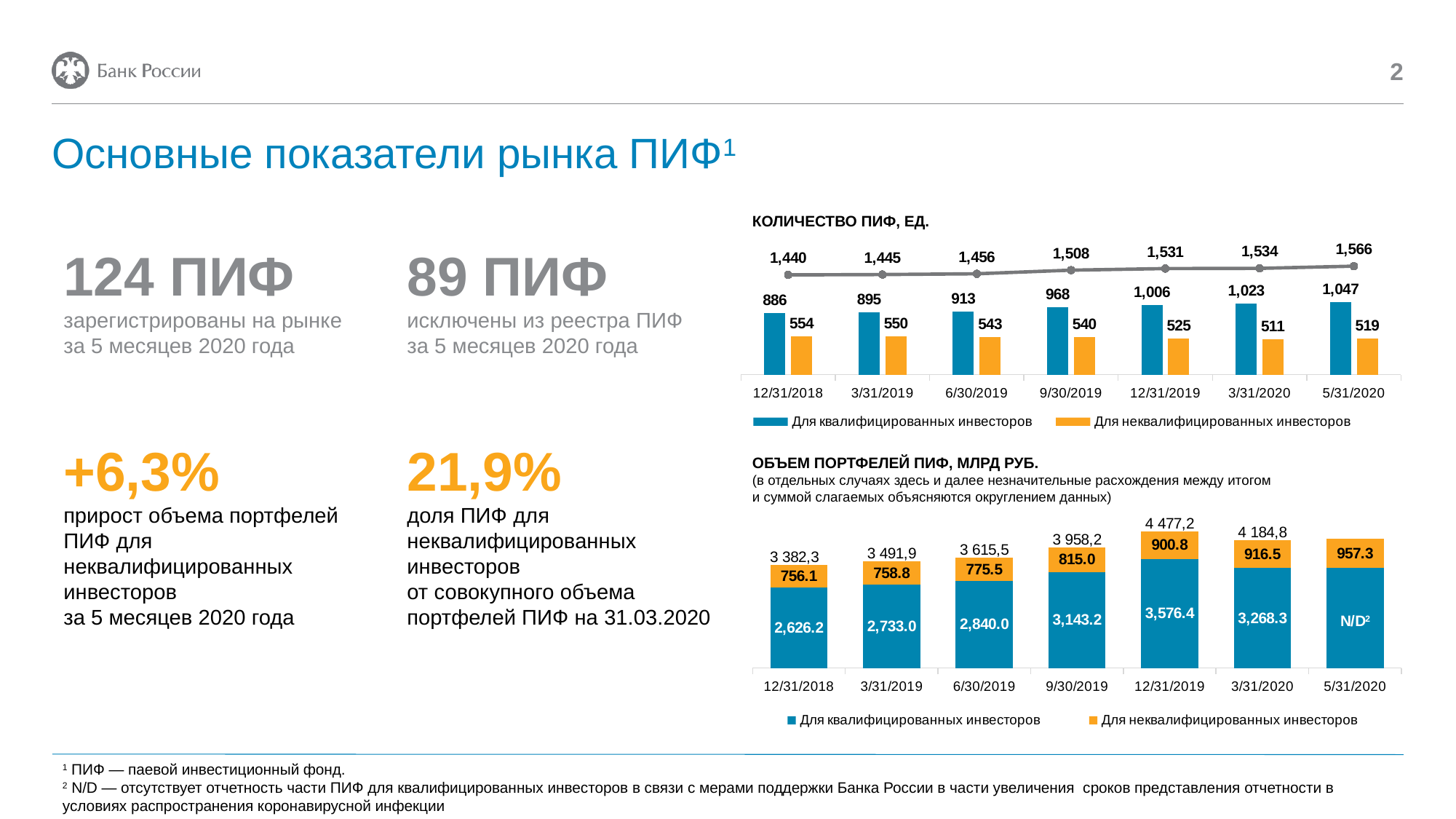
What type of chart is 'ОБЪЕМ ПОРТФЕЛЕЙ ПИФ, МЛРД РУБ.'? stacked bar chart In the chart 'КОЛИЧЕСТВО ПИФ, ЕД.', what is the value for 'Для неквалифицированных инвесторов' on 3/31/2020? 511 In the chart 'КОЛИЧЕСТВО ПИФ, ЕД.', what is the difference between the 'Для квалифицированных инвесторов' values on 5/31/2020 and 12/31/2018? 161 In the chart 'ОБЪЕМ ПОРТФЕЛЕЙ ПИФ, МЛРД РУБ.', what label is shown for 'Для квалифицированных инвесторов' on 5/31/2020? N/D In the chart 'ОБЪЕМ ПОРТФЕЛЕЙ ПИФ, МЛРД РУБ.', what is the total of the stacked bar for 12/31/2019? 4 477,2 In the chart 'КОЛИЧЕСТВО ПИФ, ЕД.', what is the value for 'Для квалифицированных инвесторов' on 12/31/2019? 1,006 In the chart 'ОБЪЕМ ПОРТФЕЛЕЙ ПИФ, МЛРД РУБ.', which is larger: the 'Для квалифицированных инвесторов' value on 12/31/2019 or on 3/31/2020? 12/31/2019 In the chart 'КОЛИЧЕСТВО ПИФ, ЕД.', on which date is the value for 'Для неквалифицированных инвесторов' lowest? 3/31/2020 In the chart 'ОБЪЕМ ПОРТФЕЛЕЙ ПИФ, МЛРД РУБ.', what is the value for 'Для неквалифицированных инвесторов' on 5/31/2020? 957.3 In the chart 'КОЛИЧЕСТВО ПИФ, ЕД.', what is the value shown on the line for 5/31/2020? 1,566 How many dates are shown on the x axis of the chart 'КОЛИЧЕСТВО ПИФ, ЕД.'? 7 In the chart 'КОЛИЧЕСТВО ПИФ, ЕД.', do the values for 'Для квалифицированных инвесторов' rise or fall from 12/31/2018 to 5/31/2020? rise